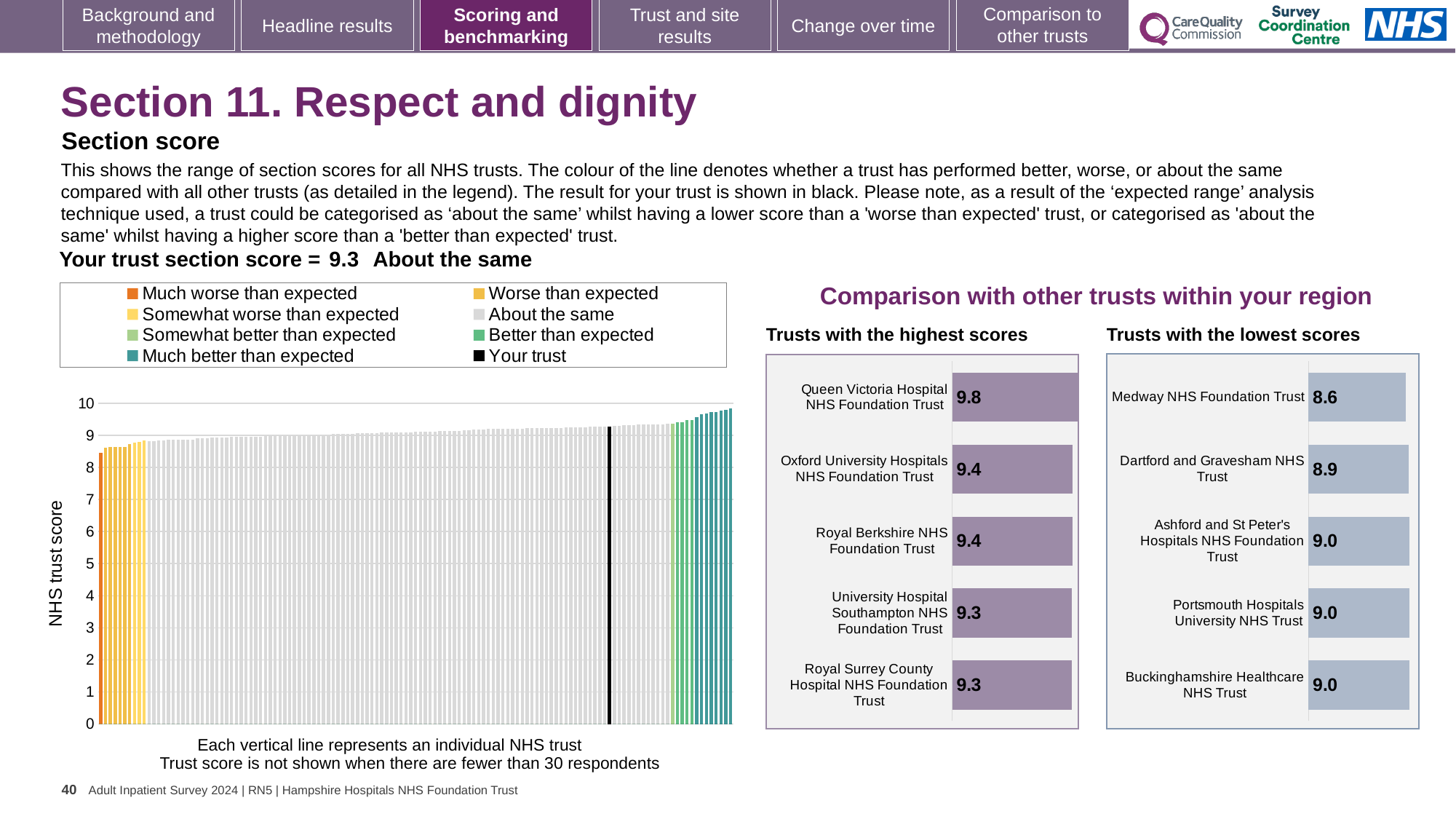
How many trusts are shown in the 'Trusts with the lowest scores' chart? 5 In the 'Trusts with the lowest scores' chart, what is the score for Dartford and Gravesham NHS Trust? 8.9 In the NHS trust score chart on the left, what colour is the line representing your trust? Black In the 'Trusts with the lowest scores' chart, what is the score for Medway NHS Foundation Trust? 8.6 In the 'Trusts with the highest scores' chart, which has the higher score: Oxford University Hospitals NHS Foundation Trust or University Hospital Southampton NHS Foundation Trust? Oxford University Hospitals NHS Foundation Trust In the 'Trusts with the lowest scores' chart, what is the difference between the scores of Dartford and Gravesham NHS Trust and Medway NHS Foundation Trust? 0.3 In the 'Trusts with the highest scores' chart, which trust has the highest score? Queen Victoria Hospital NHS Foundation Trust How many entries does the legend of the NHS trust score chart on the left list? 8 In the 'Trusts with the lowest scores' chart, which trust has the lowest score? Medway NHS Foundation Trust In the 'Trusts with the highest scores' chart, what is the score for Queen Victoria Hospital NHS Foundation Trust? 9.8 In the 'Trusts with the highest scores' chart, what is the difference between the scores of Queen Victoria Hospital NHS Foundation Trust and Royal Surrey County Hospital NHS Foundation Trust? 0.5 What kind of chart is the NHS trust score chart on the left of the slide? Bar chart